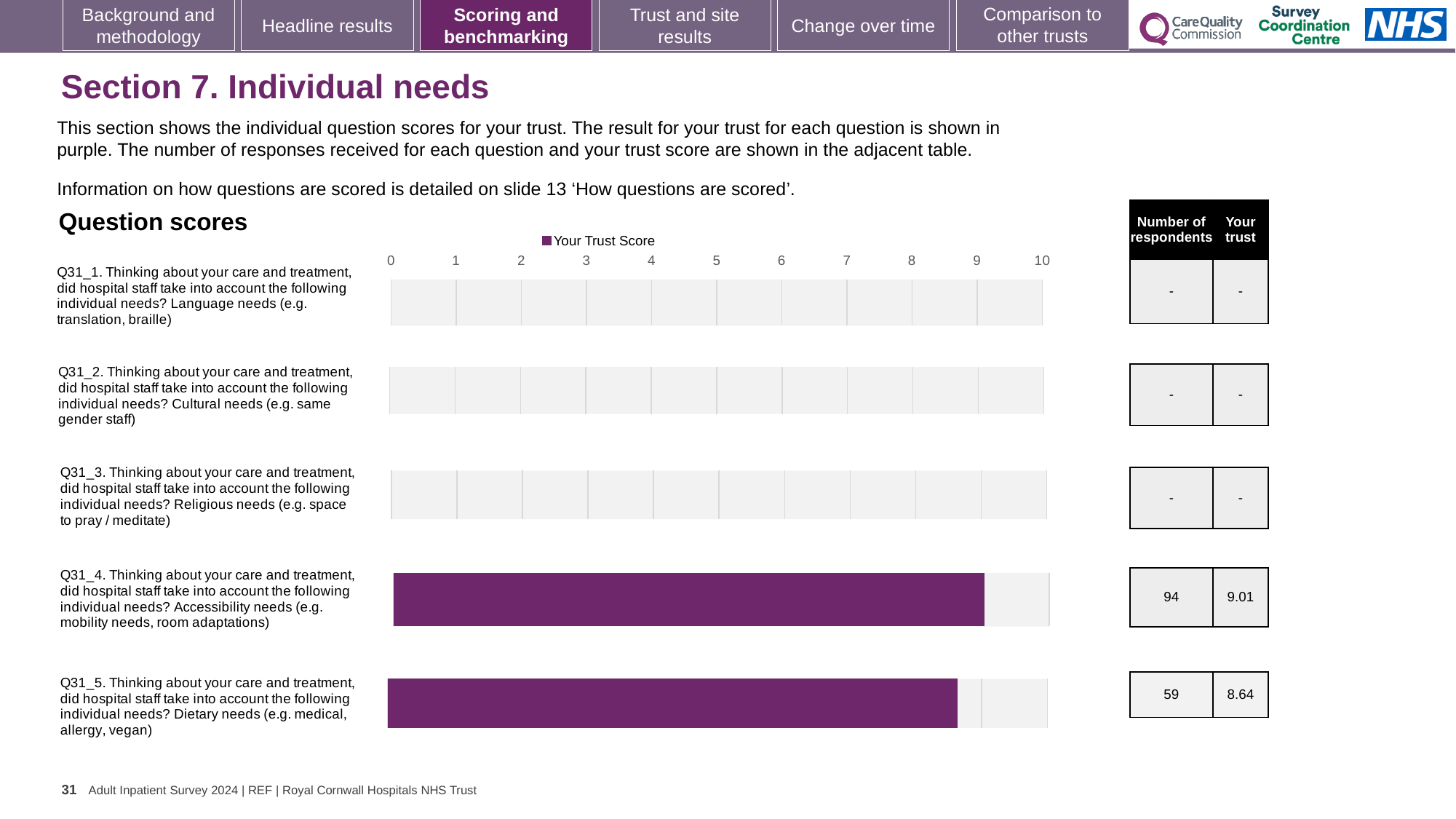
How many questions (categories) are shown in the chart? 5 What is the trust score for Q31_4 (Accessibility needs)? 9.01 What type of chart is used to show the question scores? Bar chart How many respondents answered Q31_4 (Accessibility needs)? 94 What is the trust score for Q31_5 (Dietary needs)? 8.64 Is the trust score for Q31_5 (Dietary needs) greater or less than 9? less How many respondents answered Q31_5 (Dietary needs)? 59 Which question has the highest trust score on the chart? Q31_4 (Accessibility needs) What is the difference between the trust scores for Q31_4 and Q31_5? 0.37 What is the name of the series shown in the chart legend? Your Trust Score How many series does the chart legend list? 1 What is the maximum value shown on the chart's horizontal axis? 10